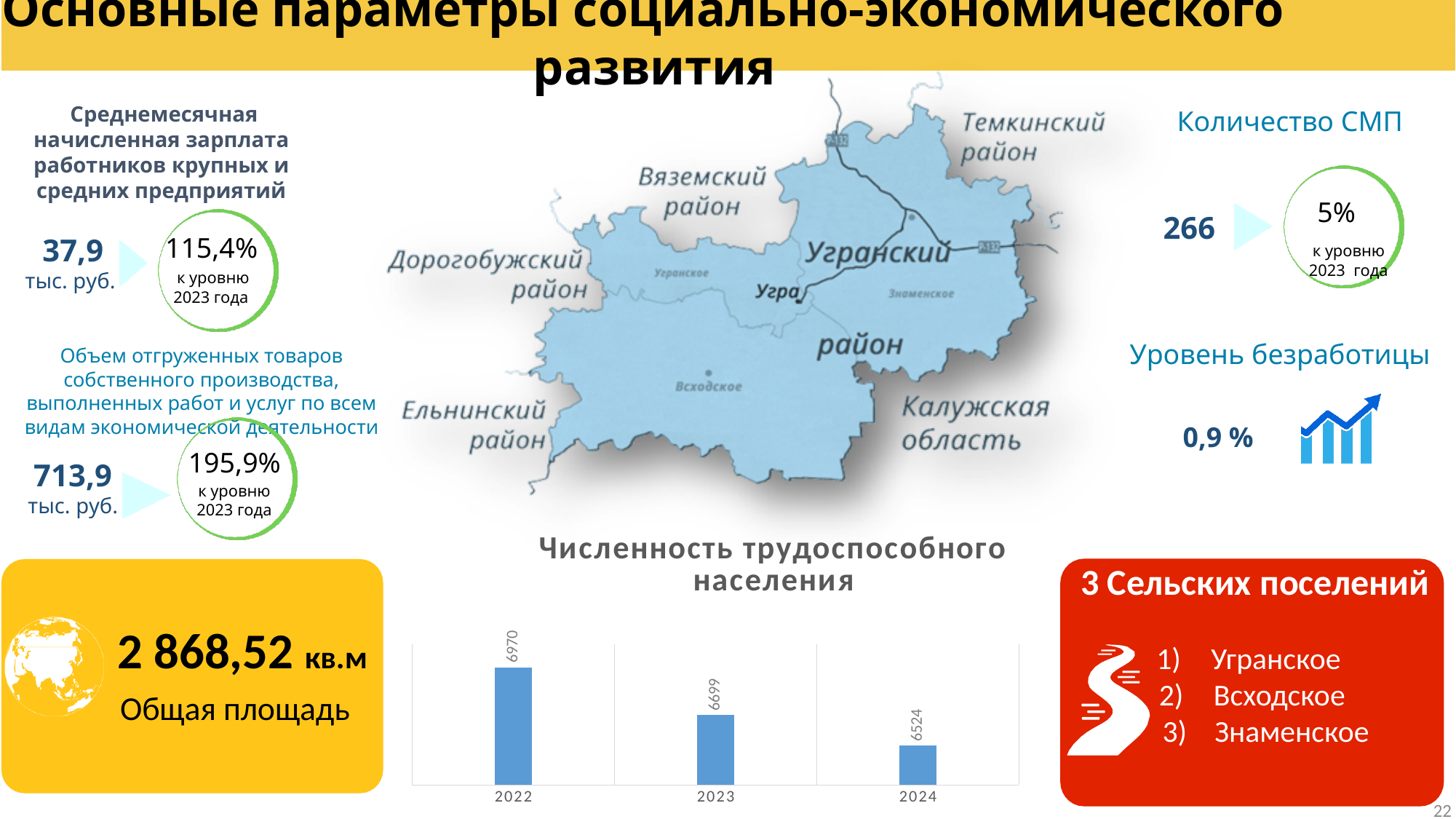
In the chart 'Численность трудоспособного населения', which is larger: the value for 2023 or the value for 2024? 2023 Which year has the highest value in the chart 'Численность трудоспособного населения'? 2022 How many years are shown in the chart 'Численность трудоспособного населения'? 3 What is the value for 2024 in the chart 'Численность трудоспособного населения'? 6524 What is the difference between the 2022 and 2023 values in the chart 'Численность трудоспособного населения'? 271 Which year has the lowest value in the chart 'Численность трудоспособного населения'? 2024 What type of chart is 'Численность трудоспособного населения'? Bar chart Do the values in the chart 'Численность трудоспособного населения' rise or fall from 2022 to 2024? Fall What is the value for 2022 in the chart 'Численность трудоспособного населения'? 6970 What is the difference between the 2022 and 2024 values in the chart 'Численность трудоспособного населения'? 446 What is the difference between the 2023 and 2024 values in the chart 'Численность трудоспособного населения'? 175 What is the value for 2023 in the chart 'Численность трудоспособного населения'? 6699